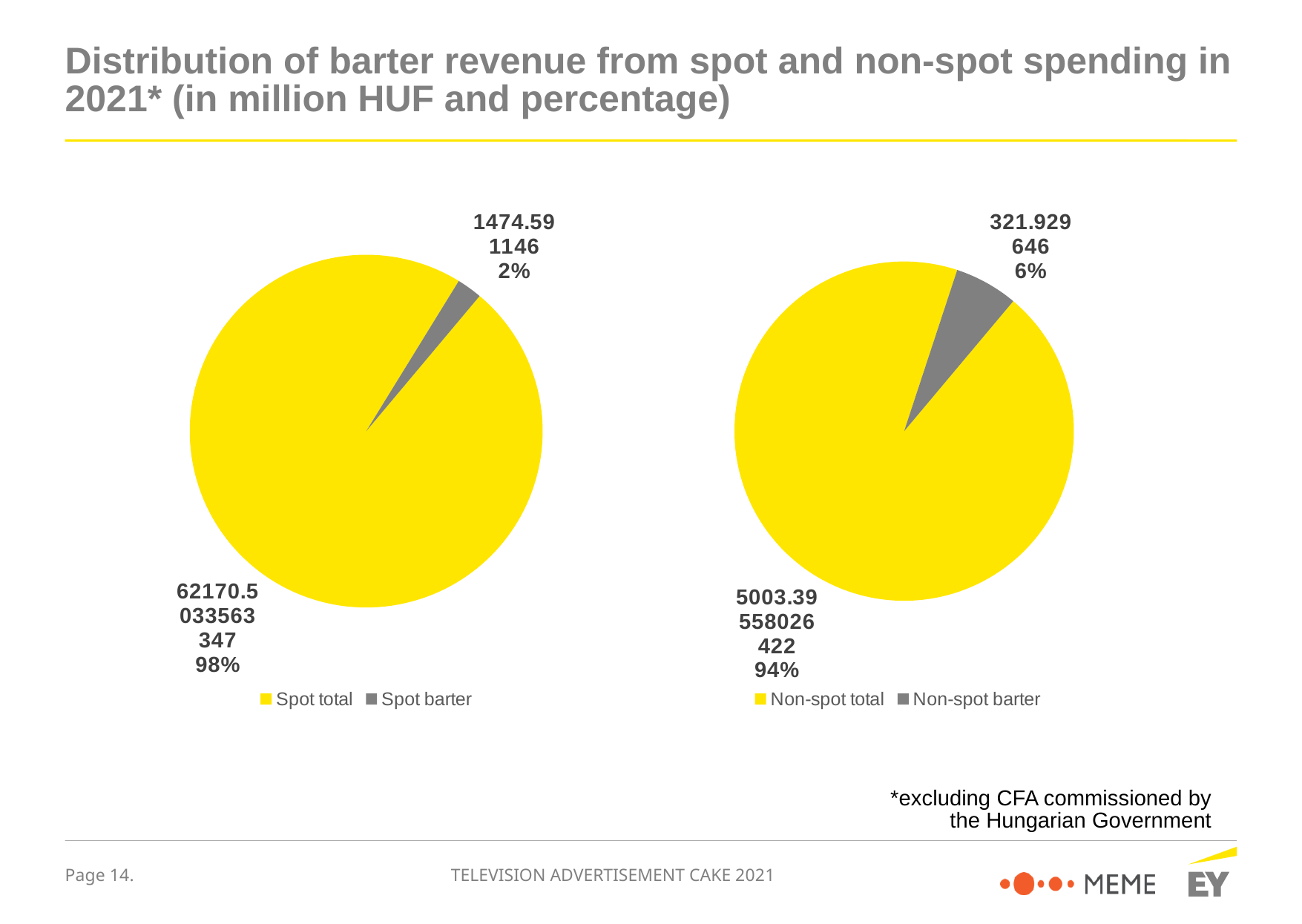
In the right pie chart, what share of the pie does Non-spot barter represent? 6% In the right pie chart, what colour is the Non-spot barter slice? Grey What is the difference in percentage points between the Non-spot barter share (right chart) and the Spot barter share (left chart)? 4 percentage points How many slices does the right pie chart have? 2 What type of chart is shown on the left of the slide? Pie chart In the right pie chart, what share of the pie does Non-spot total represent? 94% In the left pie chart, which slice is the largest? Spot total Which is larger: the Spot barter share in the left chart or the Non-spot barter share in the right chart? Non-spot barter How many entries does the legend of the left pie chart list? 2 In the left pie chart, what share of the pie does Spot barter represent? 2% In the right pie chart, which slice is the smallest? Non-spot barter